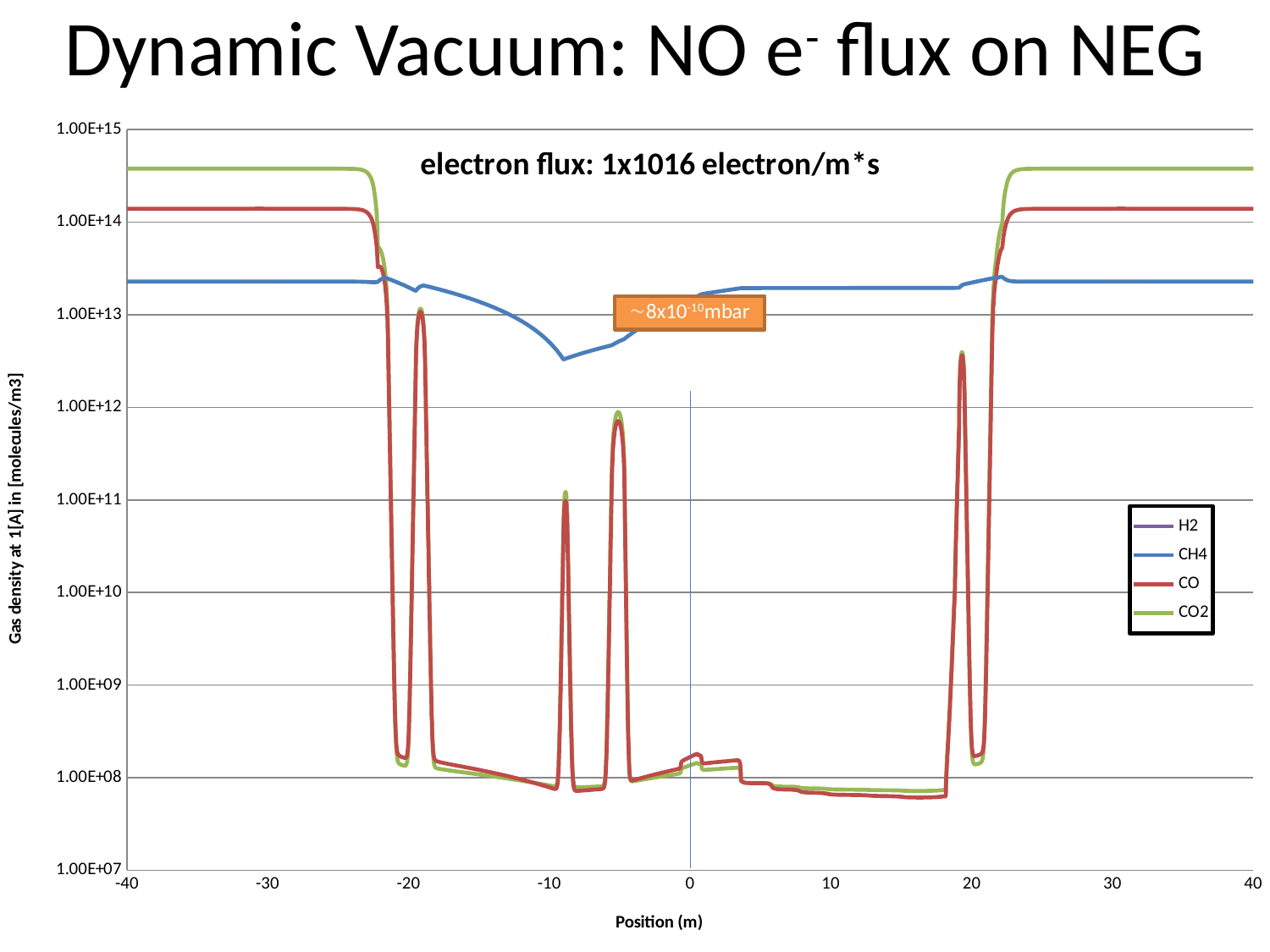
Which series are listed in the legend? H2, CH4, CO, CO2 What is the label of the x axis? Position (m) Is the CH4 value at position -40 greater or less than 1.00E+13? greater Does the CH4 line rise or fall between position -20 and position -10? fall Is the CO2 value at position -40 greater or less than 1.00E+14? greater Is the CH4 value at position -40 greater or less than 1.00E+14? less What kind of chart is shown on the slide? line chart How many series does the legend list? 4 At position 0, which series has the higher value, CH4 or CO? CH4 At position -40, which series has the higher value, CO2 or CH4? CO2